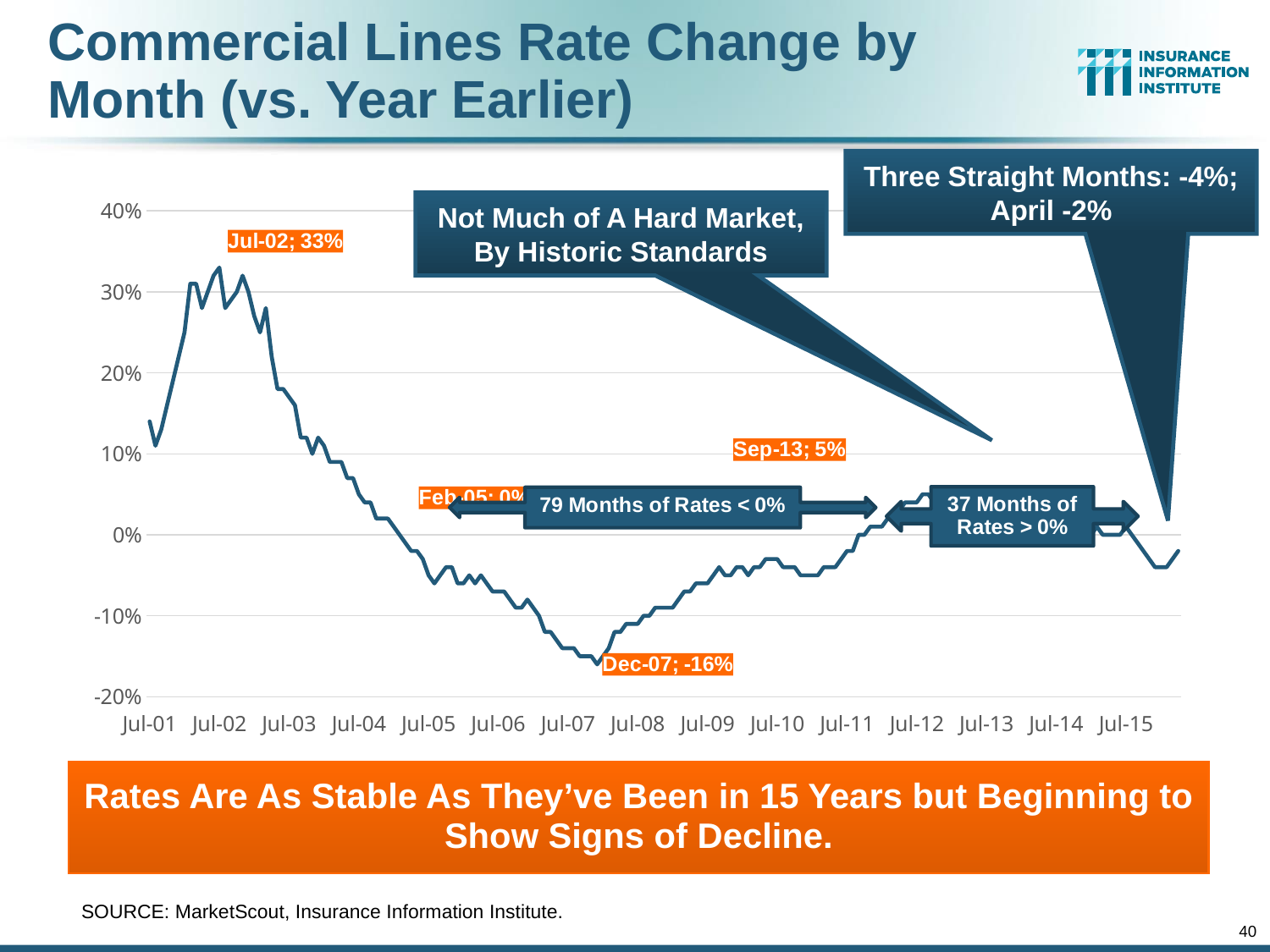
Which is larger, the rate change at Jul-02 or at Sep-13? Jul-02 What is the rate change value labeled at Jul-02? 33% Do the values rise or fall between Jul-02 and Dec-07? Fall What is the rate change value labeled at Dec-07? -16% What is the difference in percentage points between the Jul-02 value and the Dec-07 value? 49 percentage points What is the rate change value labeled at Sep-13? 5% Which labeled month has the highest rate change on the chart? Jul-02 What kind of chart is shown on the slide? Line chart According to the annotation, how many months were rates below 0%? 79 months Which labeled month has the lowest rate change on the chart? Dec-07 Is the value for Jul-03 greater or less than 10%? greater Is the value for Jul-05 greater or less than 0%? less